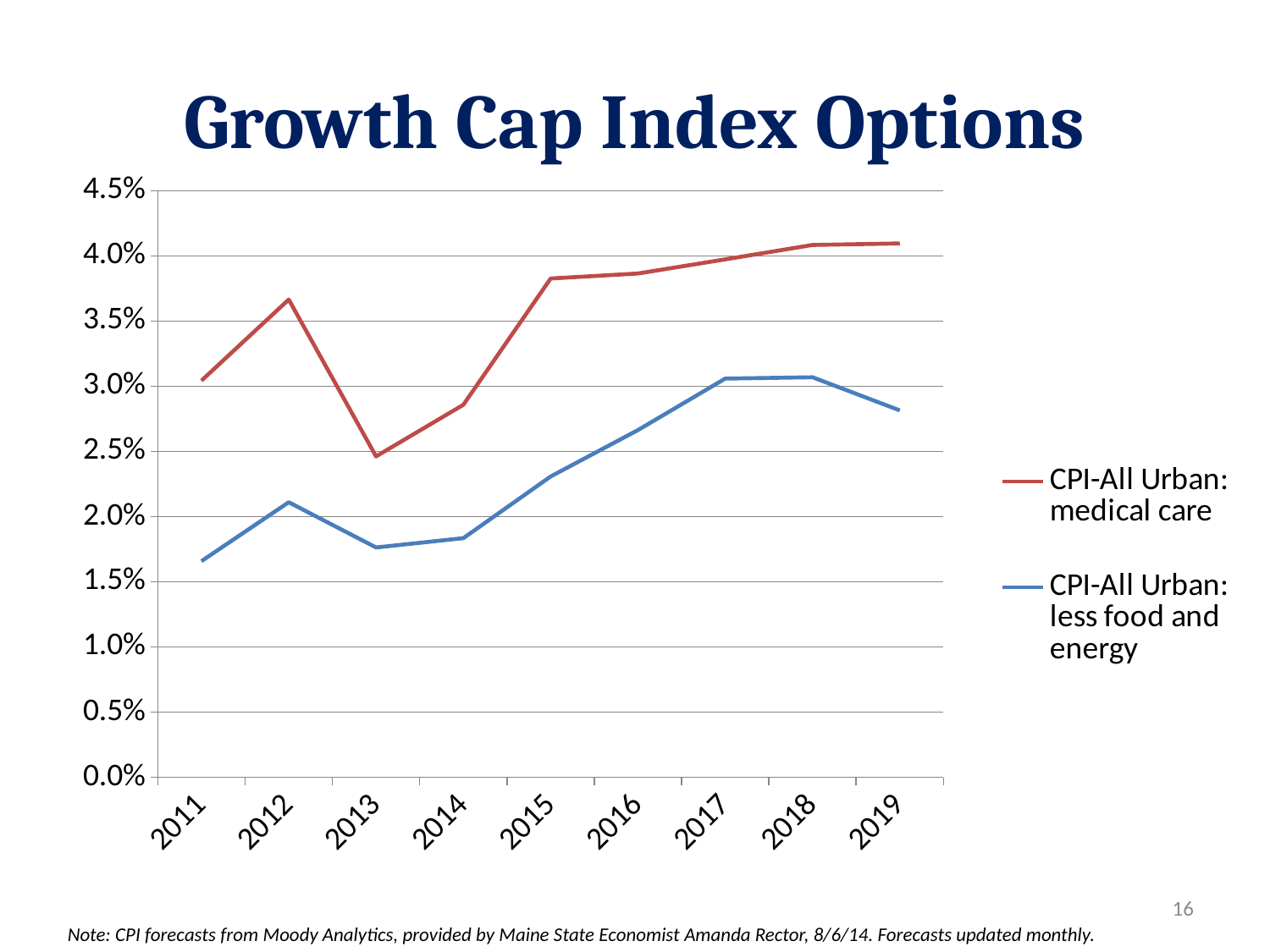
Is the CPI-All Urban: medical care value for 2013 greater or less than 3.0%? less How many series does the legend list? 2 How many years are shown on the x axis? 9 Is the CPI-All Urban: less food and energy value for 2011 greater or less than 2.0%? less Does the CPI-All Urban: less food and energy line rise or fall from 2014 to 2017? rise In which year is the CPI-All Urban: less food and energy value lowest? 2011 Is the CPI-All Urban: medical care value for 2012 greater or less than 3.5%? greater What kind of chart is shown on the slide? line chart In 2015, which series has the higher value: CPI-All Urban: medical care or CPI-All Urban: less food and energy? CPI-All Urban: medical care In which year is the CPI-All Urban: medical care value lowest? 2013 What colour is the line for CPI-All Urban: less food and energy? blue